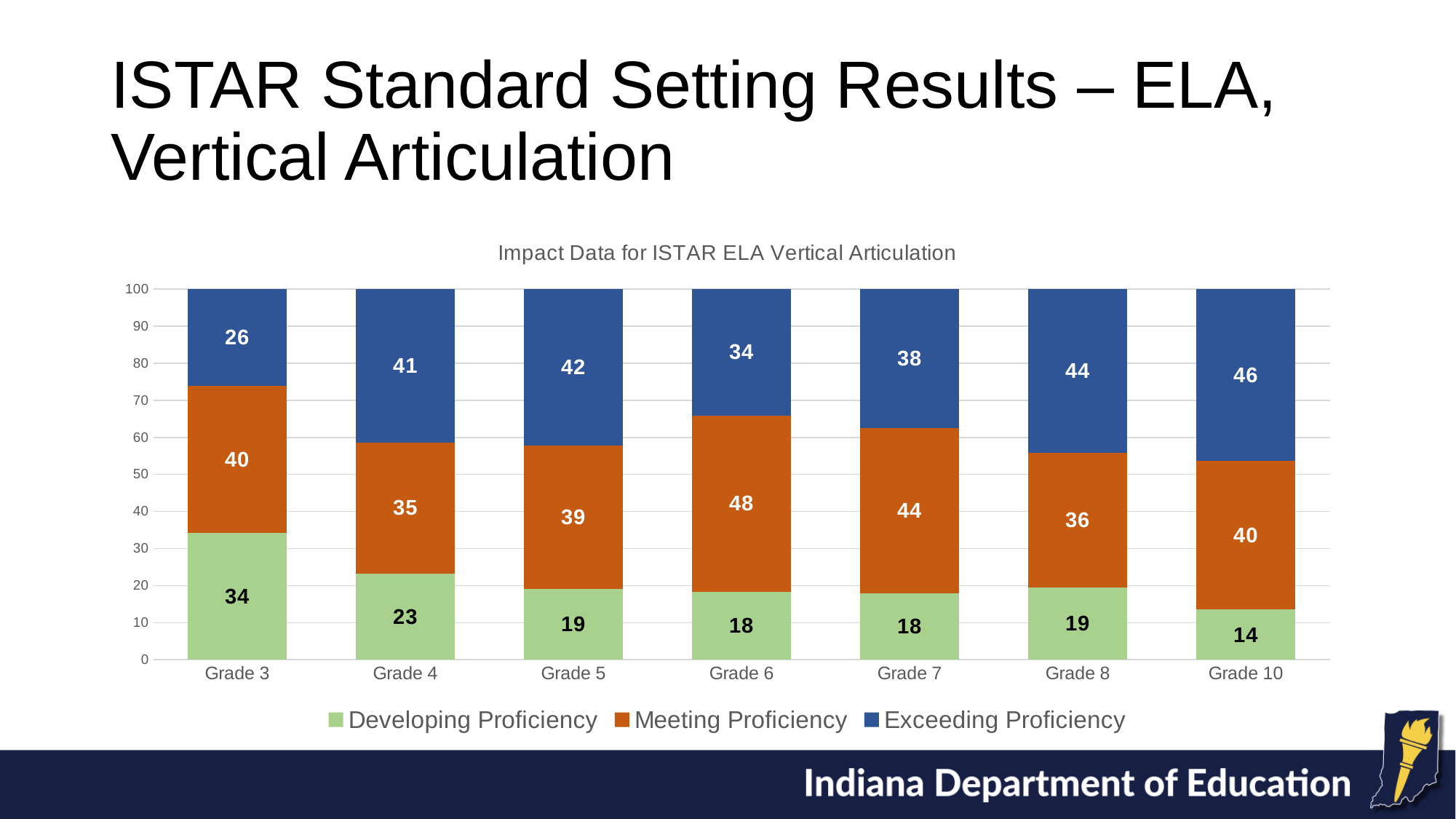
What is the title of the chart? Impact Data for ISTAR ELA Vertical Articulation Which is larger: the Meeting Proficiency value for Grade 7 or for Grade 8? Grade 7 What is the difference between the Exceeding Proficiency values for Grade 10 and Grade 3? 20 Which grade has the highest Meeting Proficiency value? Grade 6 How many series does the legend list? 3 What type of chart is shown on the slide? Stacked bar chart What is the Developing Proficiency value for Grade 3? 34 Which grade has the highest Exceeding Proficiency value? Grade 10 Which grade has the lowest Developing Proficiency value? Grade 10 What is the Meeting Proficiency value for Grade 6? 48 What is the Exceeding Proficiency value for Grade 10? 46 How many grades are shown on the x axis? 7